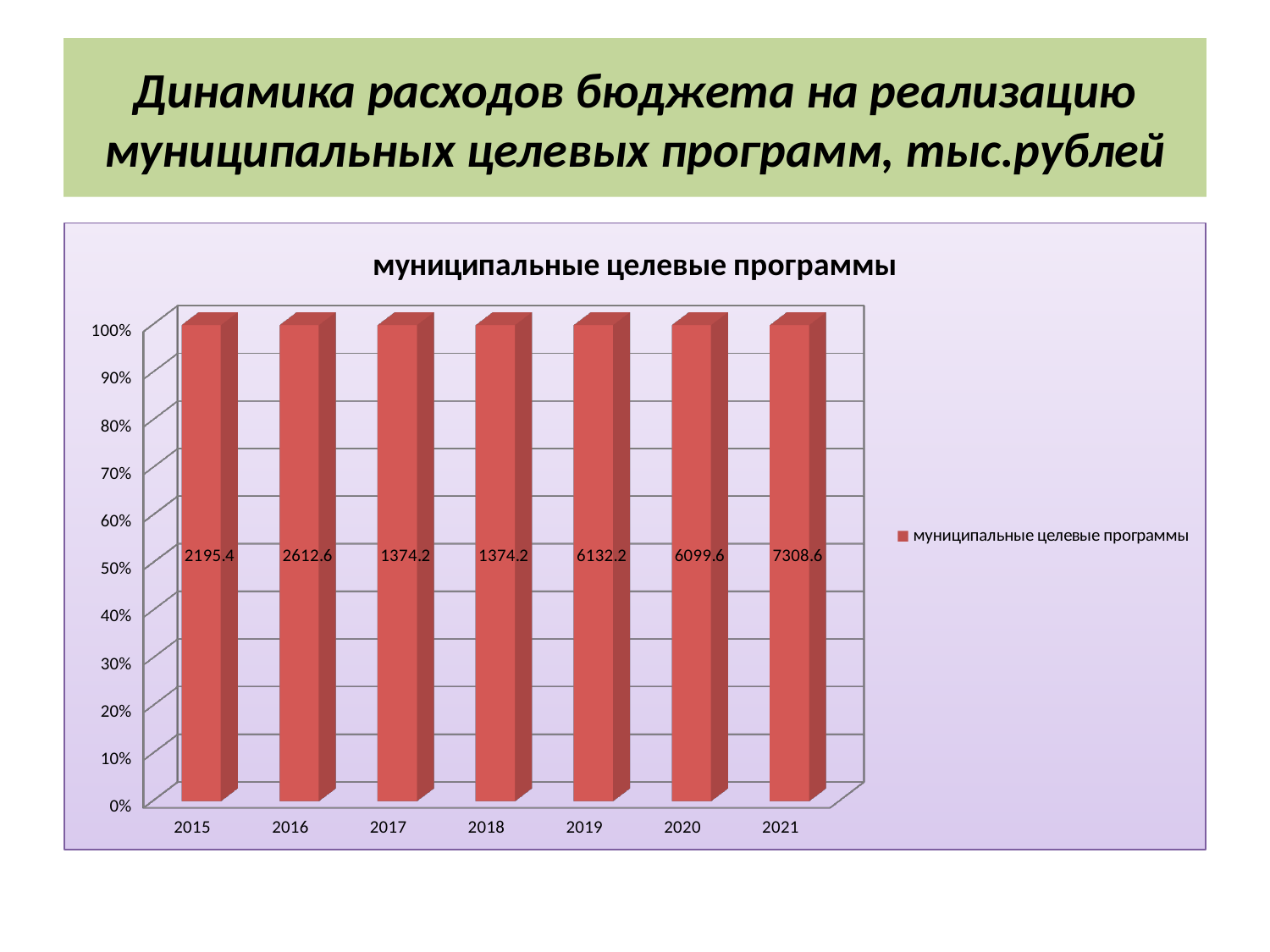
What is the data label value for 2019? 6132.2 Which year has the larger labelled value, 2019 or 2020? 2019 What is the difference between the labelled values for 2016 and 2015? 417.2 What kind of chart is shown on the slide? bar chart What is the data label value for 2015? 2195.4 What is the lowest labelled value shown on the chart? 1374.2 How many years are shown on the x axis? 7 Which year has the highest labelled value? 2021 What is the title of the chart? муниципальные целевые программы What is the difference between the labelled values for 2021 and 2020? 1209 How many series does the legend list? 1 What is the data label value for 2021? 7308.6